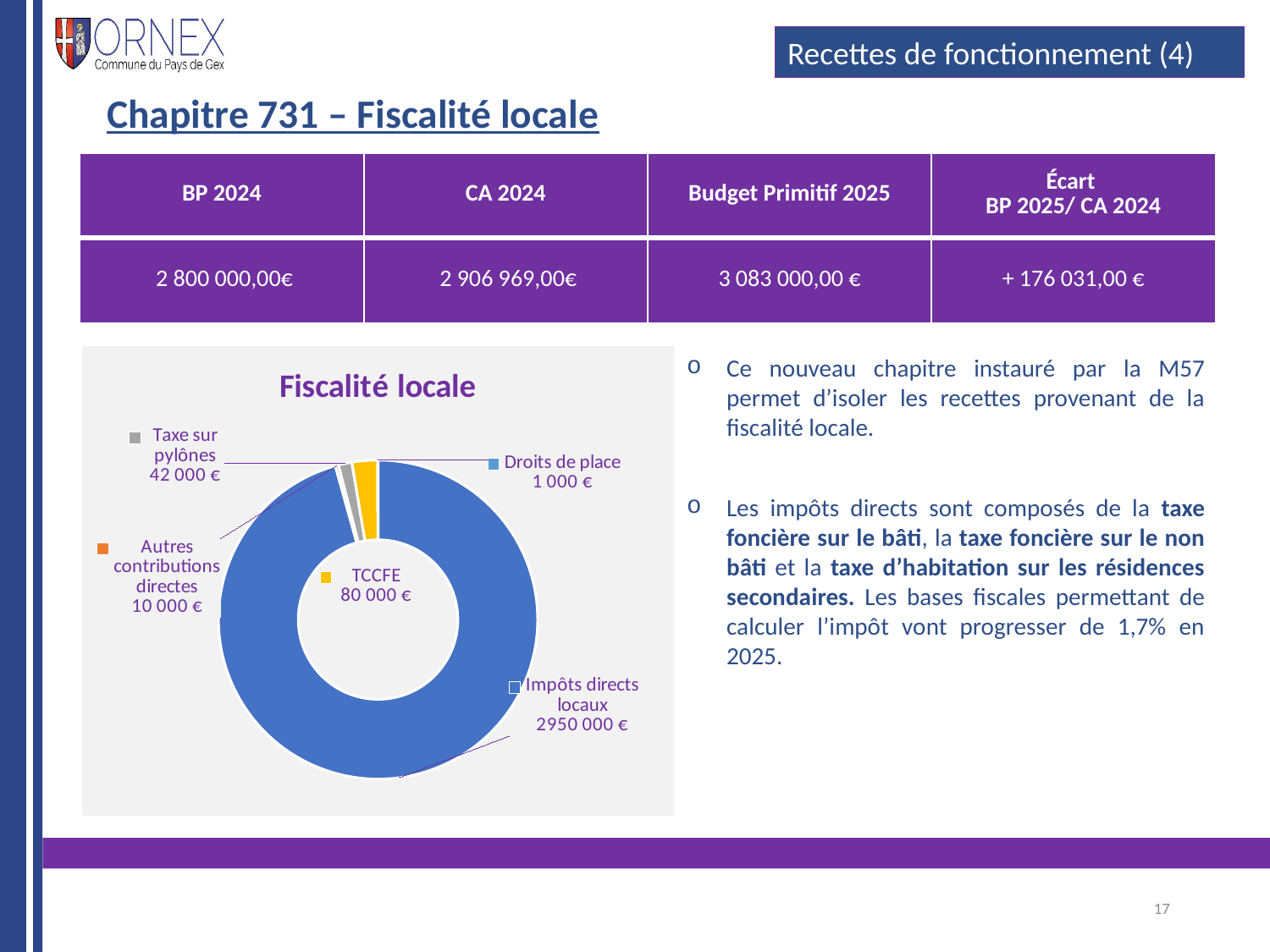
What is the difference between TCCFE and Taxe sur pylônes? 38 000 € Which category has the smallest value? Droits de place Which is larger, TCCFE or Taxe sur pylônes? TCCFE What type of chart is shown on the slide? doughnut chart What is the value for TCCFE? 80 000 € How many categories are shown in the chart? 5 What is the value for Droits de place? 1 000 € What is the value for Autres contributions directes? 10 000 € Which category has the largest value? Impôts directs locaux What is the value for Taxe sur pylônes? 42 000 € What is the title of the chart? Fiscalité locale What is the value for Impôts directs locaux? 2950 000 €